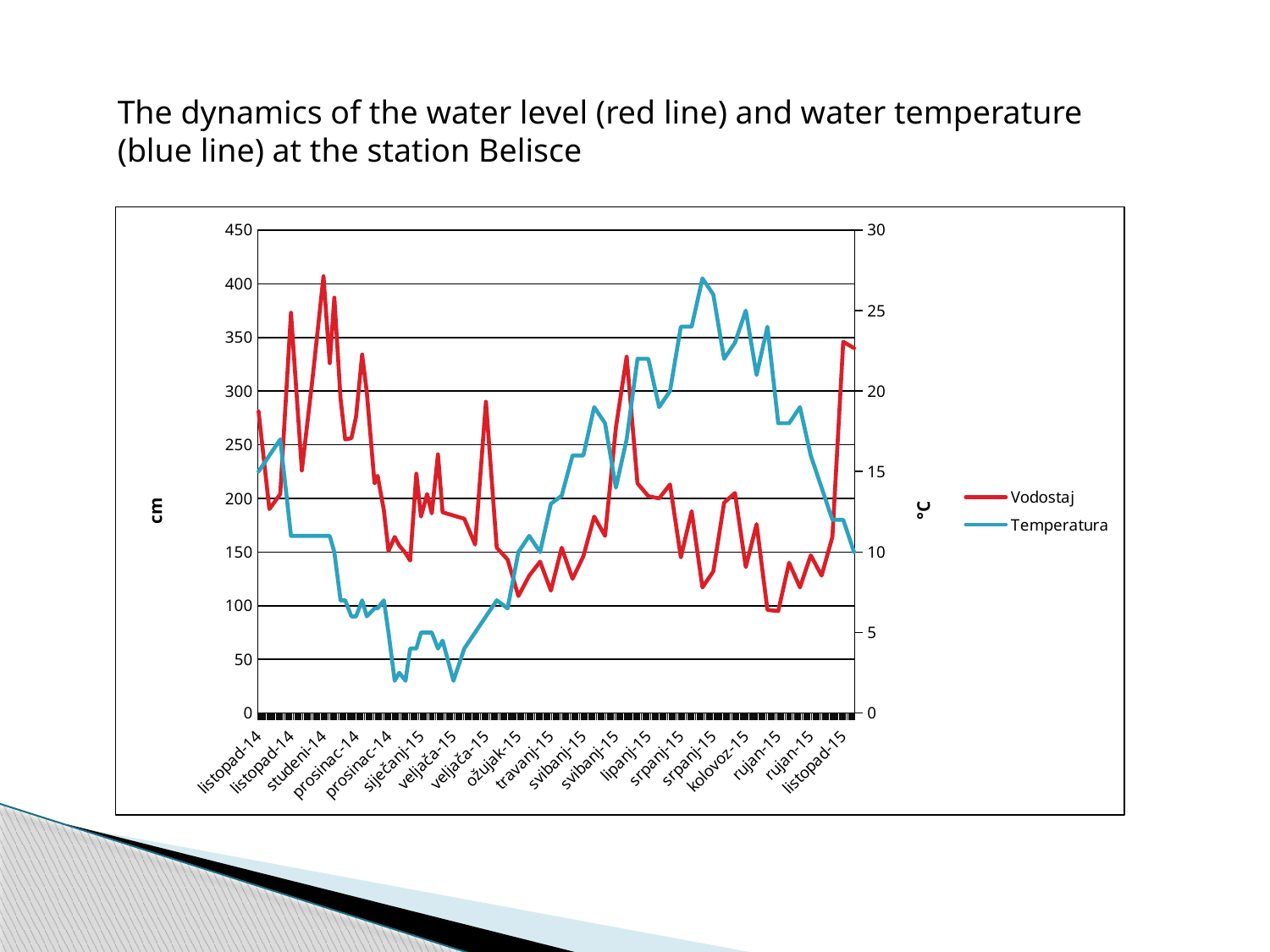
Is the Vodostaj value at listopad-15 (the last point) greater or less than 300? greater How many series does the legend list? 2 Is the highest value of the Temperatura series greater or less than 25? greater What kind of chart is shown on the slide? line chart Does the Temperatura series rise or fall between veljača-15 and srpanj-15? rise Is the lowest value of the Temperatura series greater or less than 5? less What is the label of the left vertical axis? cm Which series is drawn in red? Vodostaj Does the Temperatura series rise or fall between listopad-14 and veljača-15? fall